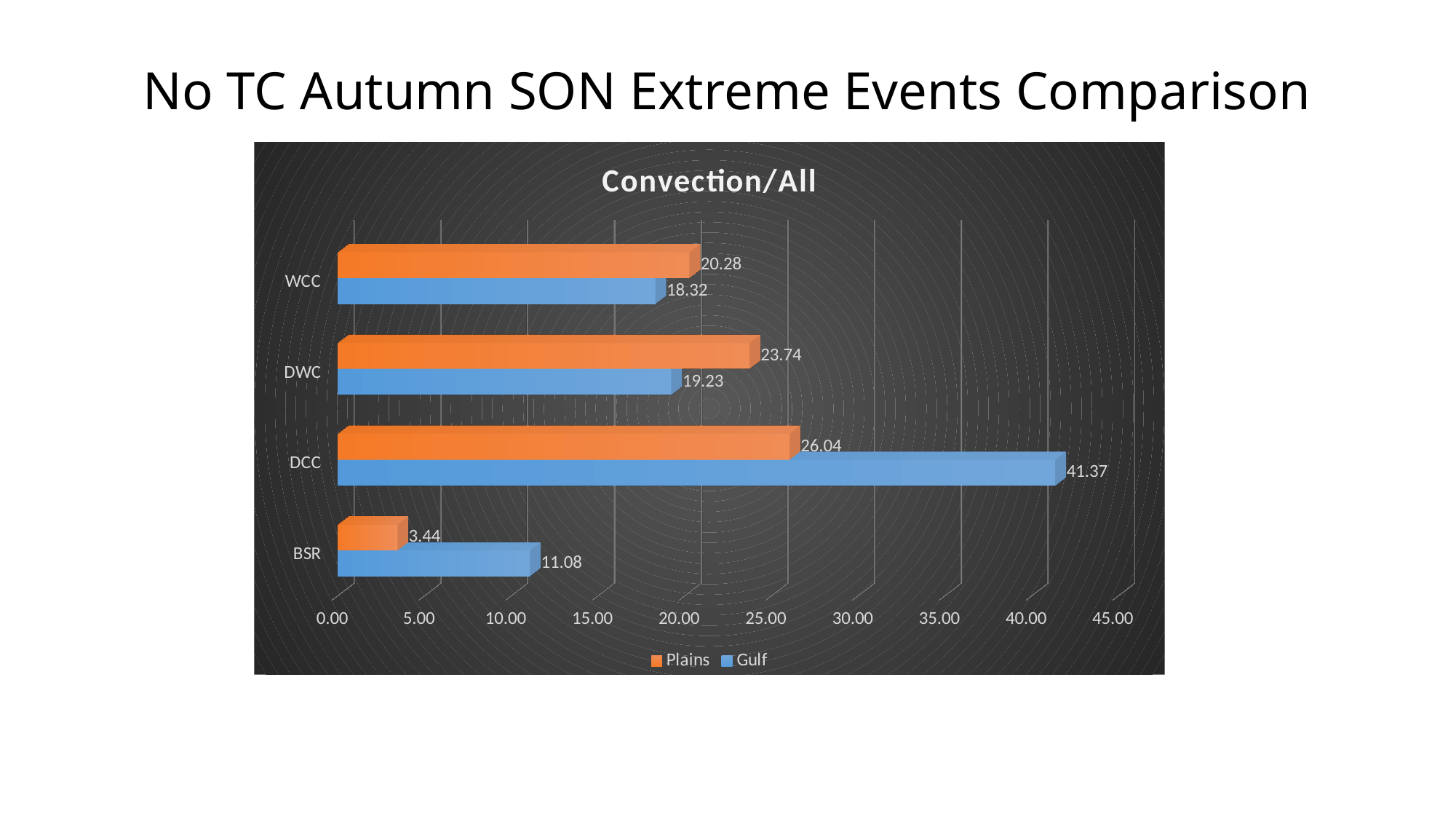
What is the difference between the Gulf and Plains values for DCC? 15.33 How many categories are shown on the chart? 4 What is the Gulf value for WCC? 18.32 What is the Plains value for DCC? 26.04 Which category has the lowest Plains value? BSR What kind of chart is shown? Bar chart What is the title of the chart? Convection/All Which is larger for WCC, the Plains value or the Gulf value? Plains What is the Plains value for DWC? 23.74 How many series does the legend list? 2 Which category has the highest Gulf value? DCC What is the Gulf value for BSR? 11.08